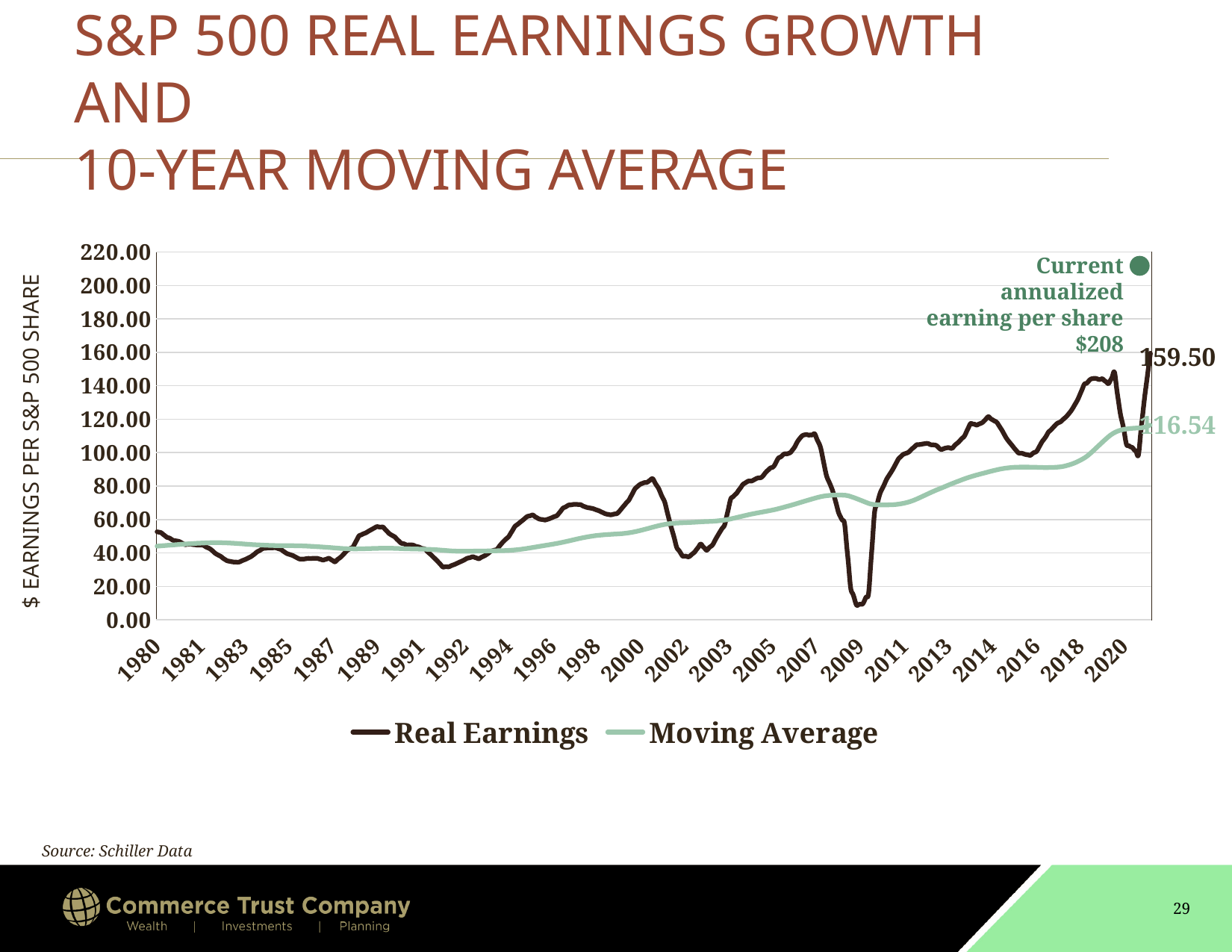
What is the difference between the final labelled Real Earnings value (159.50) and the final labelled Moving Average value (116.54)? 42.96 What is the final labelled value of the Real Earnings series? 159.50 Is the lowest point of the Real Earnings line around 2009 greater or less than 20.00? less At the right end of the chart, which series has the higher labelled value, Real Earnings or Moving Average? Real Earnings What is the title of the vertical axis? $ EARNINGS PER S&P 500 SHARE What kind of chart is shown on the slide? Line chart Is the Moving Average value at 1980 greater or less than 60.00? less Is the Real Earnings peak around 2007 greater or less than 80.00? greater How many series does the legend list? 2 What current annualized earning per share value is annotated on the chart? $208 What is the final labelled value of the Moving Average series? 116.54 Does the Moving Average line generally rise or fall from 1980 to 2020? Rise